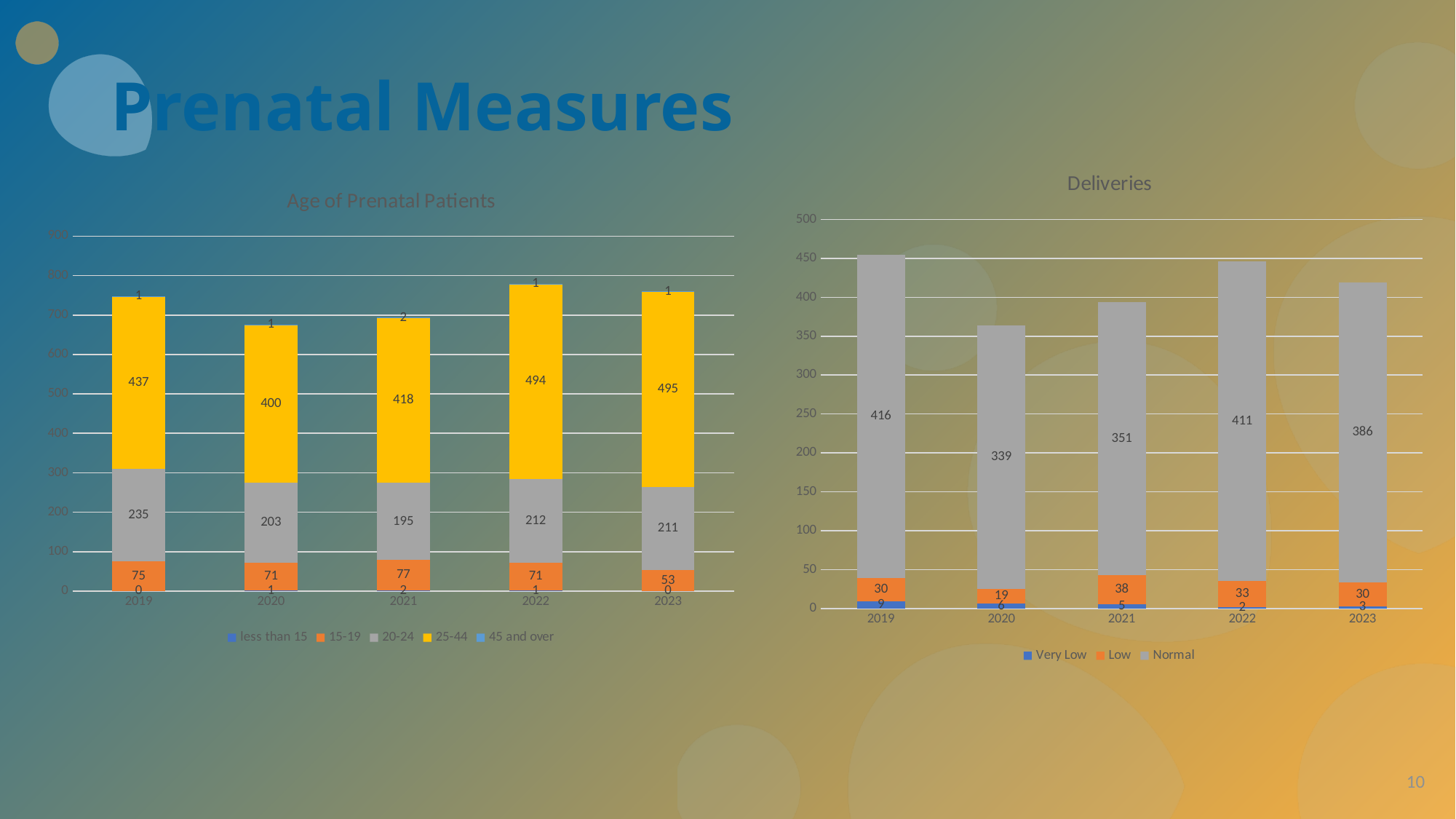
What kind of chart is the Deliveries chart? Stacked bar chart In the Age of Prenatal Patients chart, which year has the highest 25-44 value? 2023 In the Deliveries chart, is the Low value larger in 2021 or in 2023? 2021 In the Deliveries chart, what is the Low value for 2020? 19 How many years are shown on the x axis of the Deliveries chart? 5 In the Deliveries chart, which year has the lowest Normal value? 2020 In the Deliveries chart, what is the Normal value for 2022? 411 How many series does the legend of the Age of Prenatal Patients chart list? 5 In the Deliveries chart, which series is shown in grey? Normal In the Age of Prenatal Patients chart, what is the difference between the 20-24 values for 2019 and 2021? 40 In the Age of Prenatal Patients chart, what is the 25-44 value for 2021? 418 In the Deliveries chart, what is the total of the stacked bar for 2019? 455